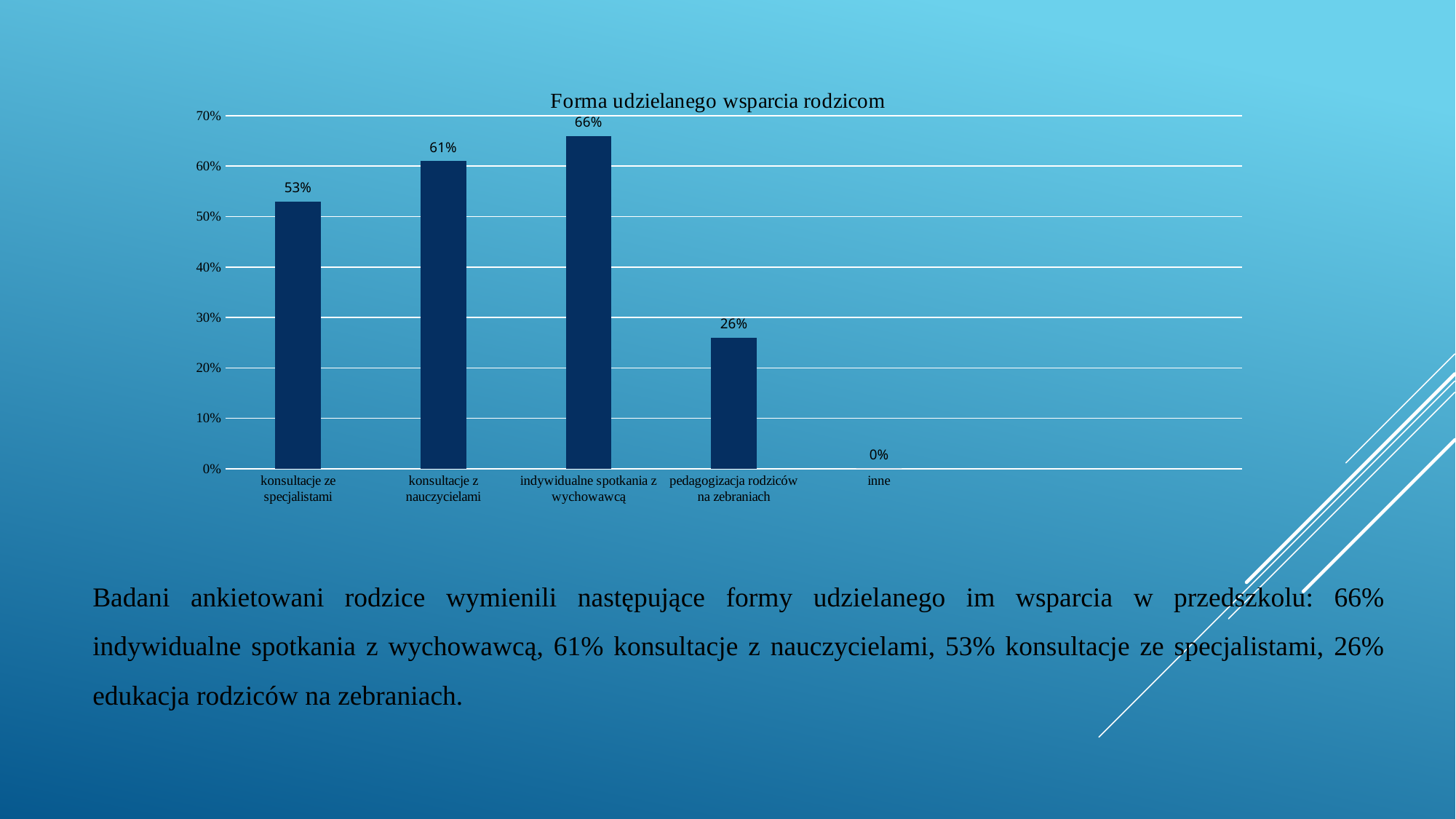
Which category has the lowest value? inne What is the title of the chart? Forma udzielanego wsparcia rodzicom What is the value for 'inne'? 0% Which is larger: 'konsultacje ze specjalistami' or 'pedagogizacja rodziców na zebraniach'? konsultacje ze specjalistami What is the value for 'konsultacje z nauczycielami'? 61% Which category has the highest value? indywidualne spotkania z wychowawcą What is the value for 'konsultacje ze specjalistami'? 53% What is the value for 'indywidualne spotkania z wychowawcą'? 66% What is the difference between 'indywidualne spotkania z wychowawcą' and 'konsultacje z nauczycielami'? 5% What kind of chart is shown on the slide? bar chart How many categories are shown on the x axis? 5 What is the value for 'pedagogizacja rodziców na zebraniach'? 26%